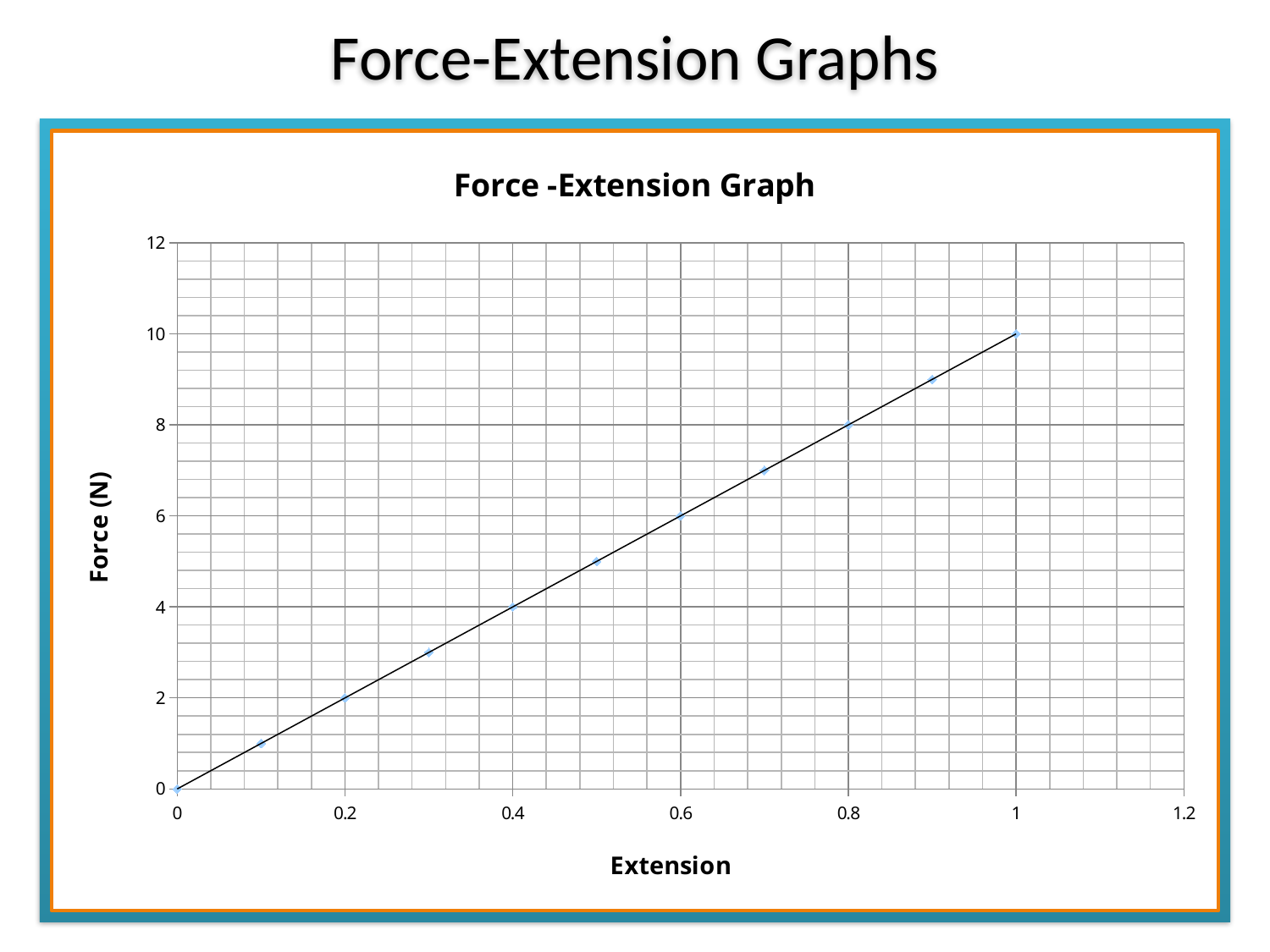
Is the force value at an extension of 0.3 greater or less than 4? less What is the force value at an extension of 0.4? 4 What is the force value at an extension of 0.2? 2 What type of chart is shown on the slide? line chart How many data points are plotted on the chart? 11 What is the label of the vertical axis? Force (N) What is the title of the chart? Force -Extension Graph What is the difference between the force at an extension of 1 and the force at an extension of 0.6? 4 What is the force value at an extension of 0.8? 8 What is the force value at an extension of 1? 10 Is the force value at an extension of 0.5 greater or less than 4? greater Do the force values rise or fall as extension increases? rise